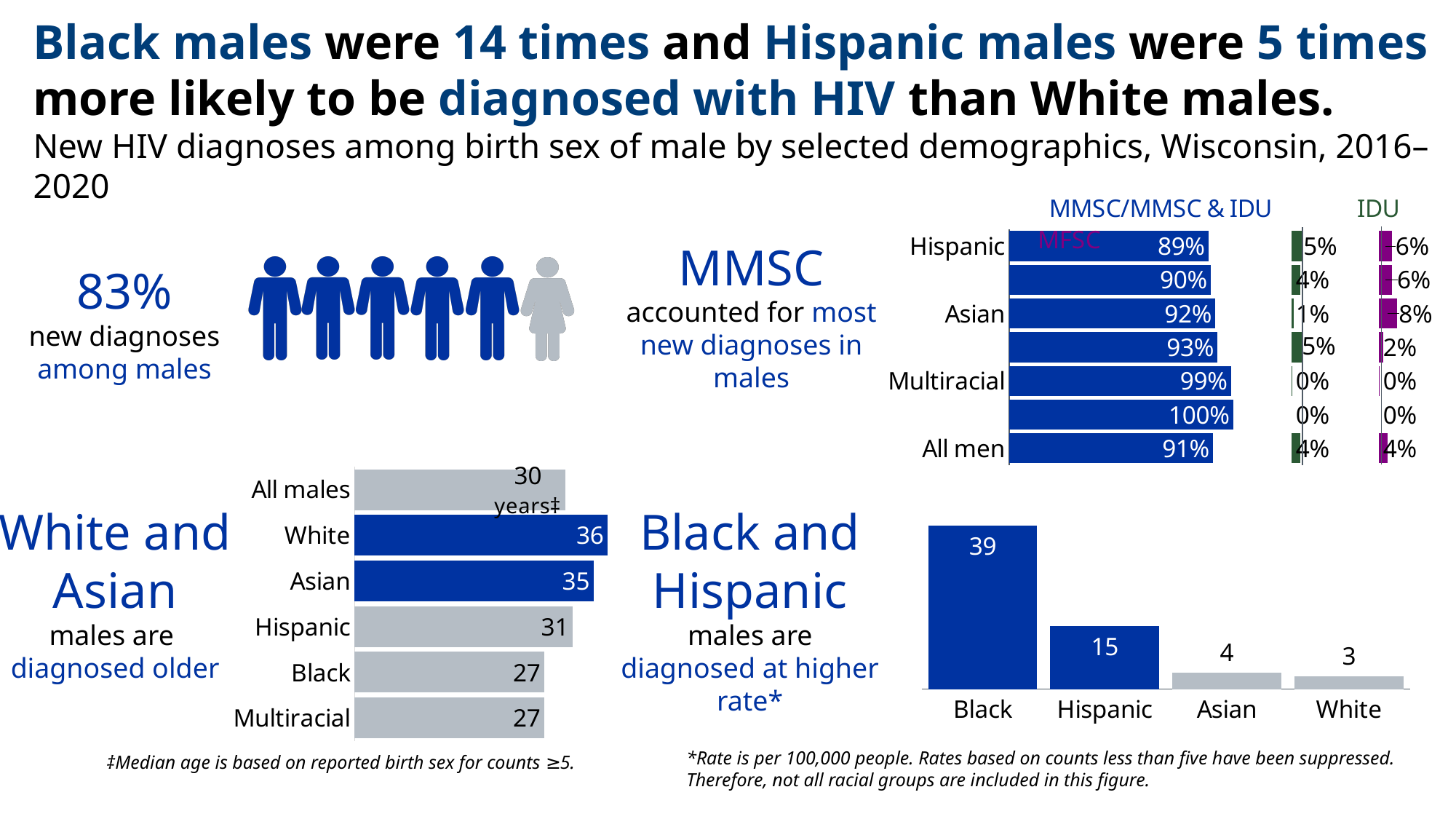
In the bottom-left median age chart, how many categories are shown? 6 In the bottom-left median age chart, what is the median age at diagnosis for White males? 36 What type of chart is the bottom-right chart showing diagnosis rates by race? bar chart In the bottom-left median age chart, what is the difference in median age between White and Black males? 9 In the bottom-left median age chart, what is the median age at diagnosis for Hispanic males? 31 In the bottom-right rate chart, is the rate for Hispanic males higher or lower than the rate for Asian males? higher In the bottom-right rate chart, what is the difference between the rates for Black and Hispanic males? 24 In the bottom-right rate chart, which group has the lowest diagnosis rate? White In the bottom-left median age chart, which group has the highest median age at diagnosis? White In the top-right chart, what is the IDU percentage for All men? 4% In the top-right chart, what percentage of new diagnoses among All men is attributed to MMSC/MMSC & IDU? 91% In the bottom-right rate chart, what is the diagnosis rate for Black males? 39